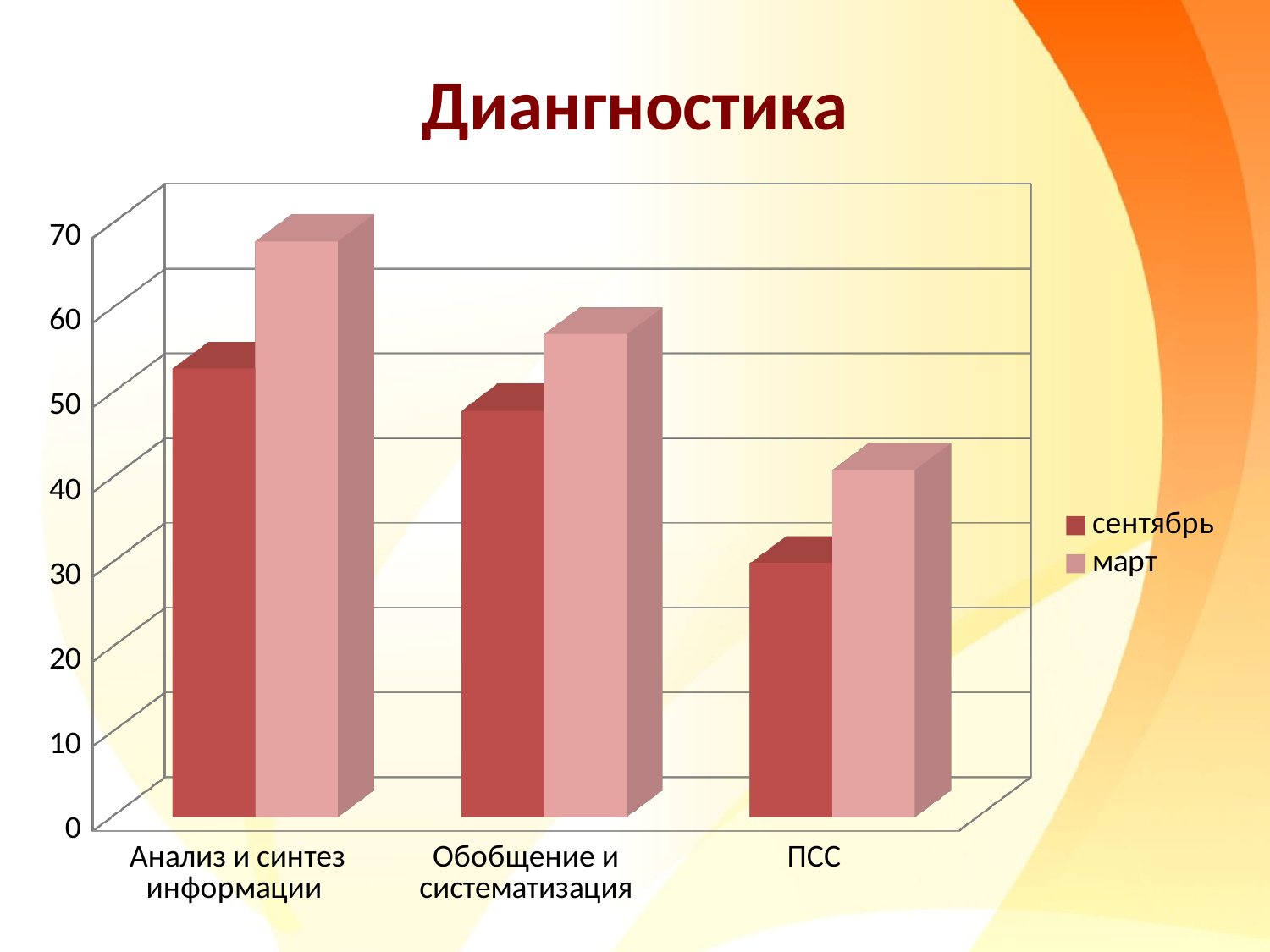
How many categories are shown on the x axis of the chart? 3 Which category has the lowest value for the сентябрь series? ПСС Is the март value for Анализ и синтез информации greater or less than 60? greater For ПСС, which series has the larger value, сентябрь or март? март What kind of chart is shown on the slide? bar chart Is the март value for ПСС greater or less than 50? less How many series does the chart's legend list? 2 Is the сентябрь value for ПСС greater or less than 40? less Which category has the highest value for the март series? Анализ и синтез информации What is the title of the chart on the slide? Диангностика Do the сентябрь values rise or fall from left to right across the categories? fall Which series does the legend list first? сентябрь